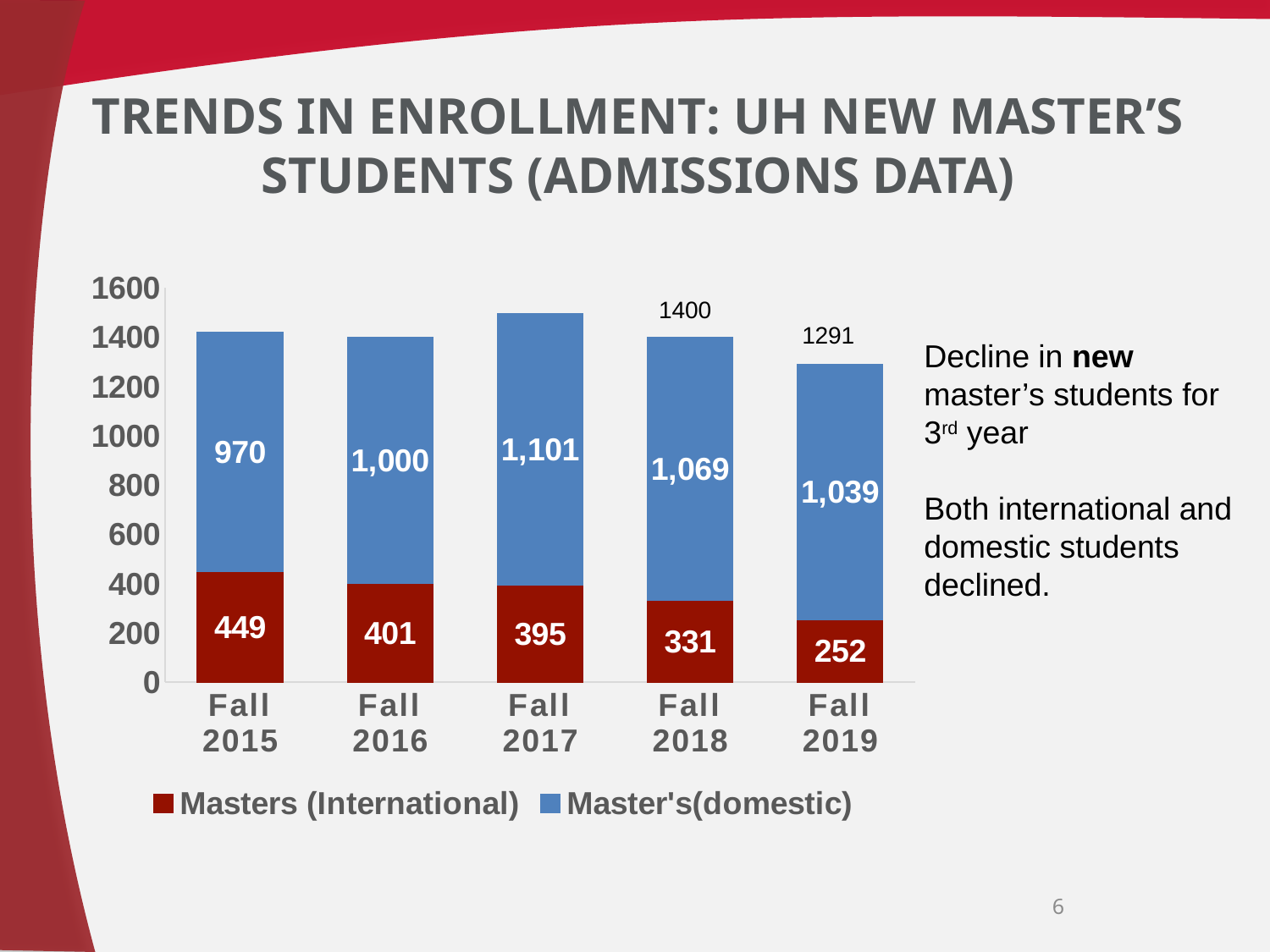
What is the value for Masters (International) in Fall 2019? 252 What is the value for Masters (International) in Fall 2015? 449 Which is larger: Master's(domestic) in Fall 2018 or Master's(domestic) in Fall 2016? Fall 2018 How many series does the legend list? 2 What kind of chart is shown on the slide? Stacked bar chart What is the total of the stacked bar for Fall 2018? 1400 What is the difference between the Masters (International) values for Fall 2015 and Fall 2019? 197 What is the total of the stacked bar for Fall 2016? 1401 Which year has the lowest Masters (International) value? Fall 2019 What is the value for Master's(domestic) in Fall 2017? 1,101 Which year has the highest Master's(domestic) value? Fall 2017 How many years are shown on the x axis? 5